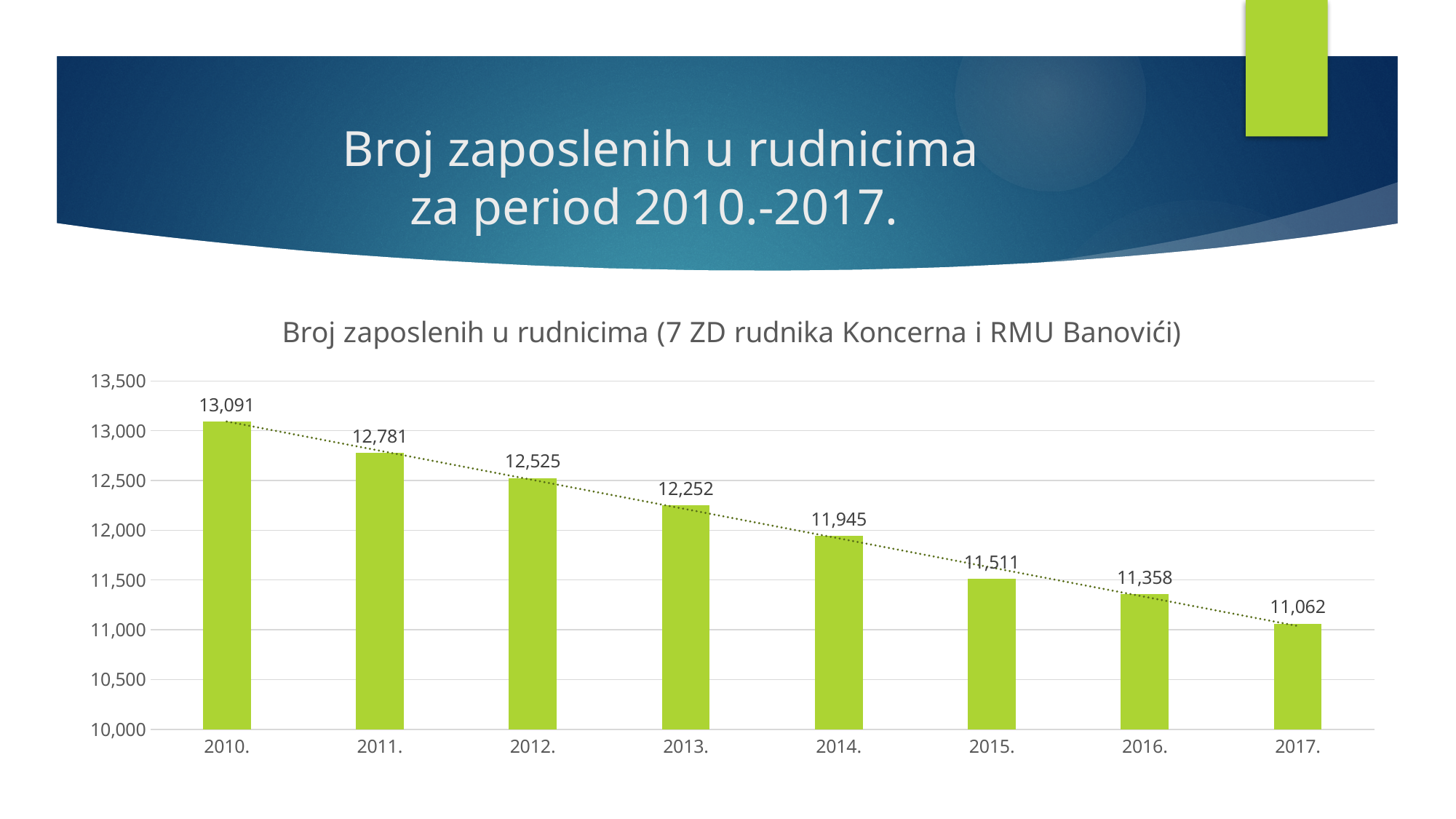
What kind of chart is shown on the slide? bar chart Do the values rise or fall from 2010. to 2017.? fall Which is larger, the value for 2015. or the value for 2016.? 2015. What is the difference between the values for 2010. and 2017.? 2,029 Is the value for 2013. greater or less than 12,000? greater Which year has the lowest number of employees? 2017. What is the number of employees shown for 2010.? 13,091 What is the number of employees shown for 2014.? 11,945 What is the difference between the values for 2012. and 2013.? 273 Which year has the highest number of employees? 2010. What is the number of employees shown for 2017.? 11,062 How many years are shown on the x axis? 8